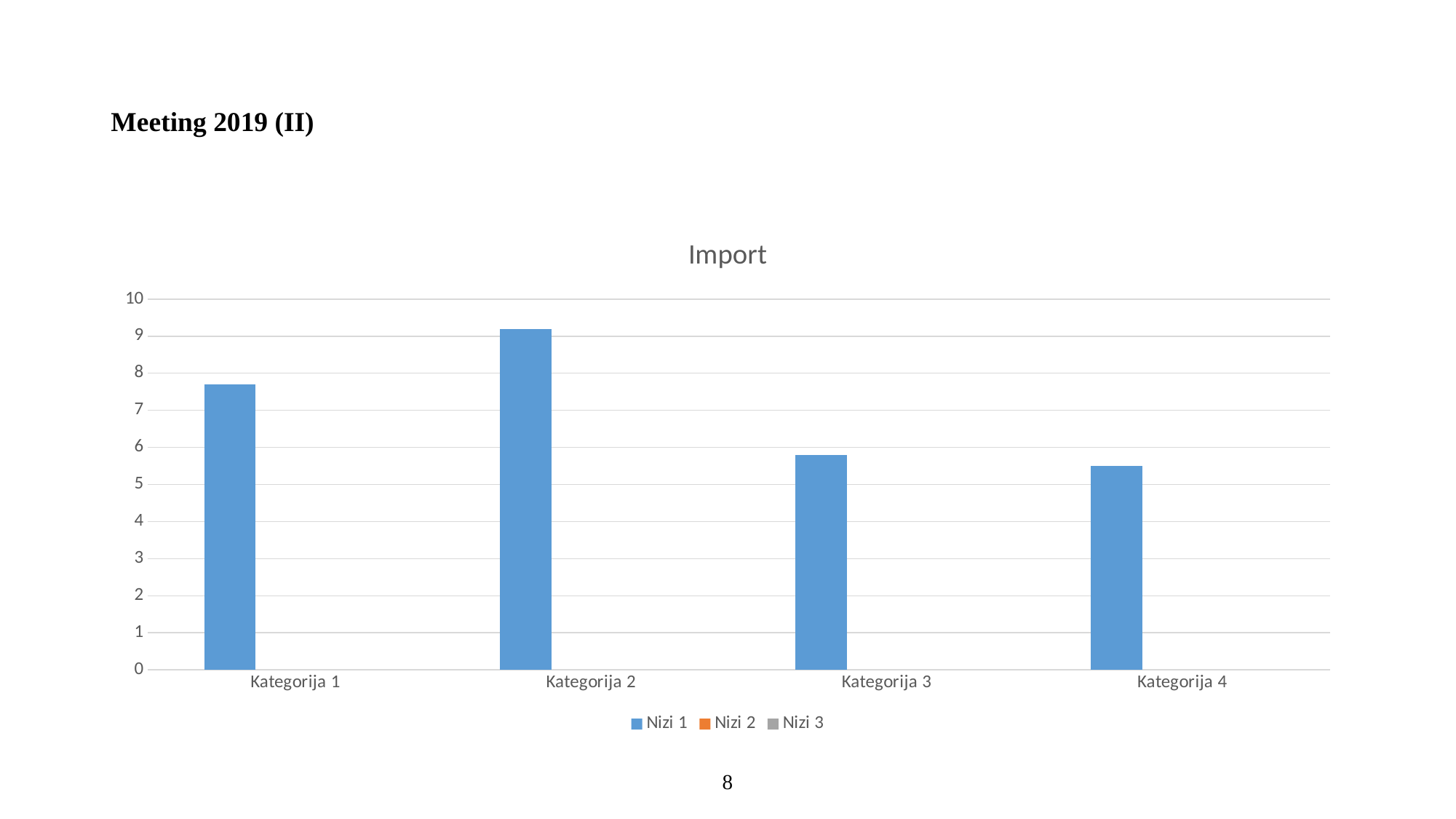
Is the value for Kategorija 2 greater or less than 8? greater Which is larger, the value for Kategorija 1 or the value for Kategorija 3? Kategorija 1 Is the value for Kategorija 3 greater or less than 5? greater How many series does the chart's legend list? 3 Is the value for Kategorija 1 greater or less than 7? greater How many categories are shown on the x axis of the chart? 4 What colour are the bars for the series Nizi 1? blue What is the title of the chart? Import Which category has the highest value in the chart? Kategorija 2 Does the value rise or fall from Kategorija 2 to Kategorija 3? fall What kind of chart is shown on the slide? bar chart